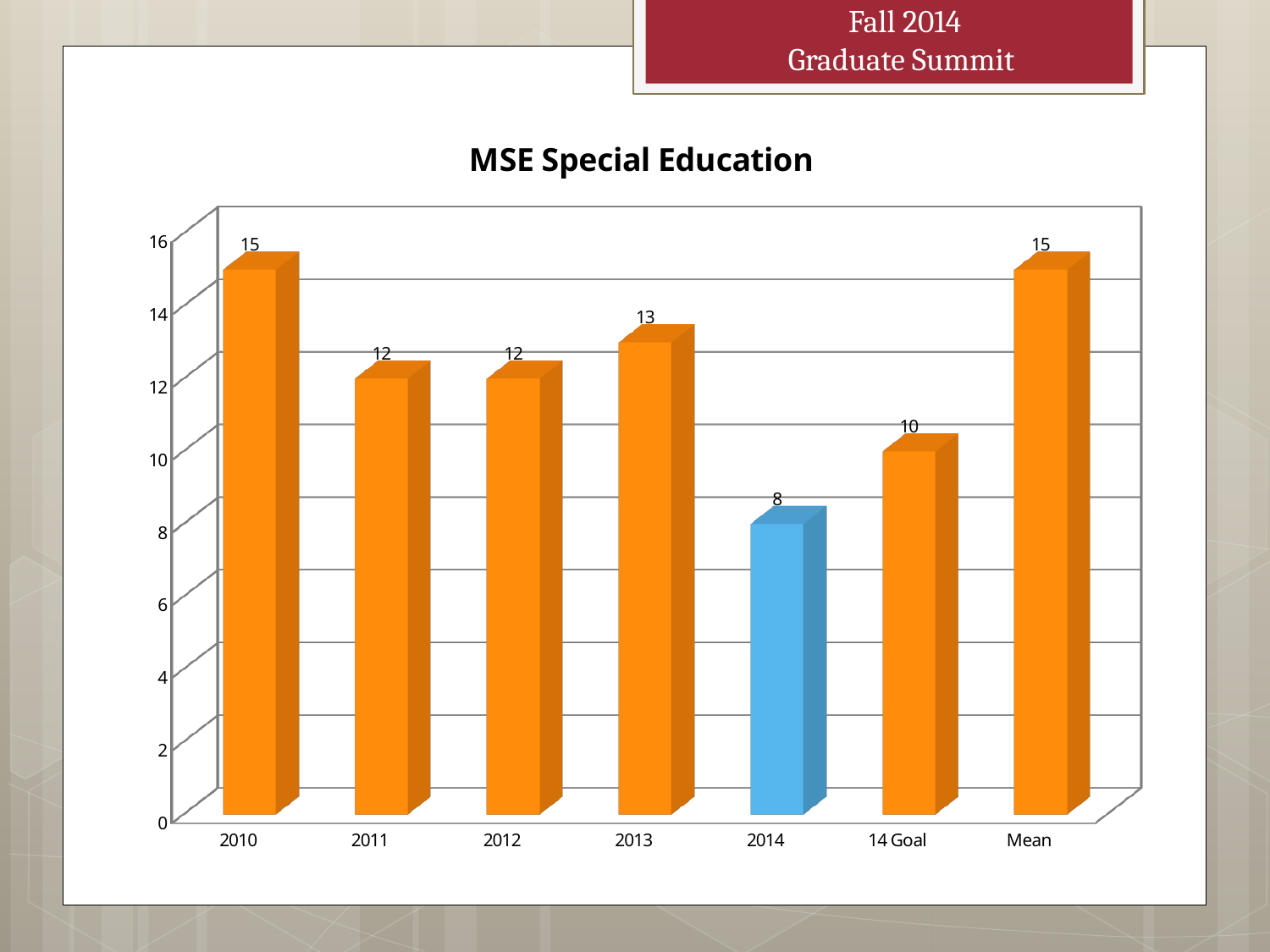
What is the difference between the 2010 value and the 2014 value in the MSE Special Education chart? 7 What is the value for Mean in the MSE Special Education chart? 15 What is the value for 2013 in the MSE Special Education chart? 13 Which category has the lowest value in the MSE Special Education chart? 2014 What kind of chart is the MSE Special Education chart? bar chart Which is larger in the MSE Special Education chart, the value for 2013 or the value for 2011? 2013 Which bar in the MSE Special Education chart is coloured blue rather than orange? 2014 Do the values fall or rise from 2013 to 2014 in the MSE Special Education chart? fall How many categories are shown on the x axis of the MSE Special Education chart? 7 What is the difference between the 14 Goal value and the 2014 value in the MSE Special Education chart? 2 What is the value for 14 Goal in the MSE Special Education chart? 10 What is the value for 2014 in the MSE Special Education chart? 8